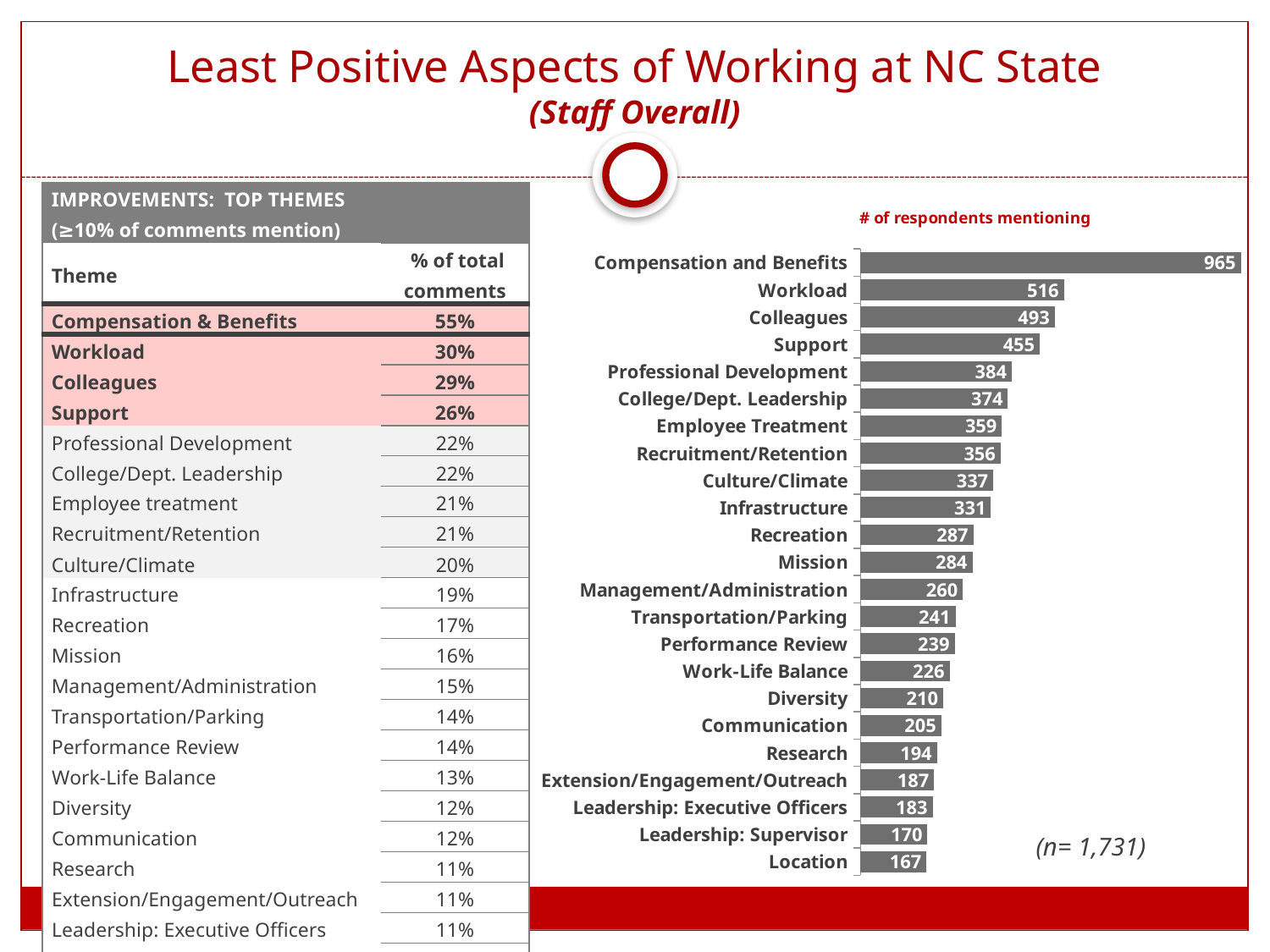
Which category has the lowest number of respondents mentioning it? Location Which has more respondents mentioning it, Professional Development or Infrastructure? Professional Development What kind of chart is shown on the slide? bar chart What is the label shown above the bar chart describing what the bars measure? # of respondents mentioning How many respondents mentioned Leadership: Supervisor? 170 Which has more respondents mentioning it, Recreation or Diversity? Recreation What is the difference between the number of respondents mentioning Compensation and Benefits and the number mentioning Support? 510 How many respondents mentioned Compensation and Benefits? 965 How many respondents mentioned Culture/Climate? 337 Which category has the highest number of respondents mentioning it? Compensation and Benefits How many categories are plotted in the bar chart? 23 What is the difference between the number of respondents mentioning Workload and the number mentioning Colleagues? 23